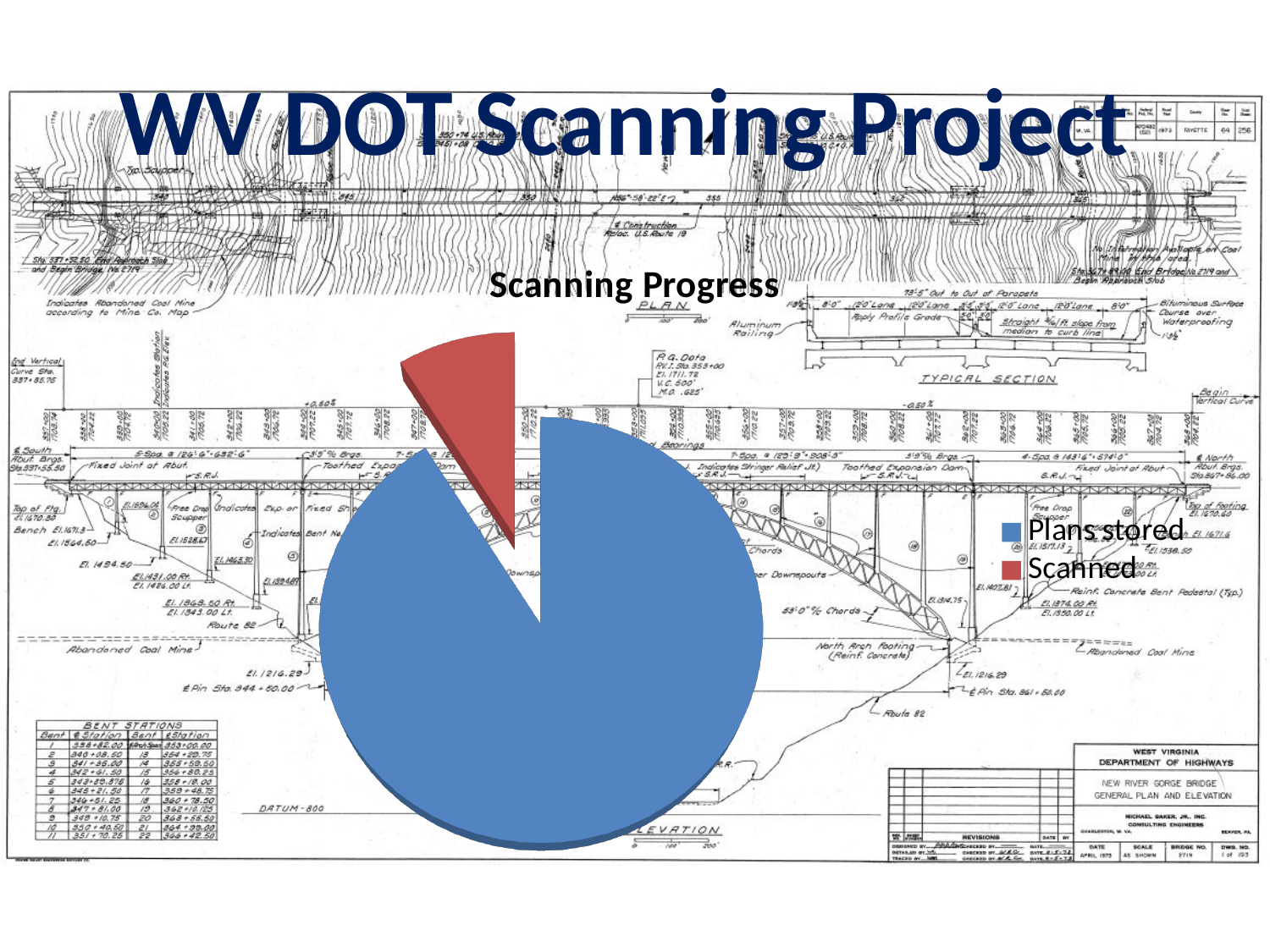
What kind of chart is shown on the slide? pie chart Does the Scanned slice represent more or less than half of the pie? less What is the title of the chart? Scanning Progress What colour is the slice for Scanned? red How many slices does the pie chart have? 2 Which is larger, the slice for Plans stored or the slice for Scanned? Plans stored How many entries does the chart's legend list? 2 Which category has the smallest slice of the pie? Scanned Which category has the largest slice of the pie? Plans stored